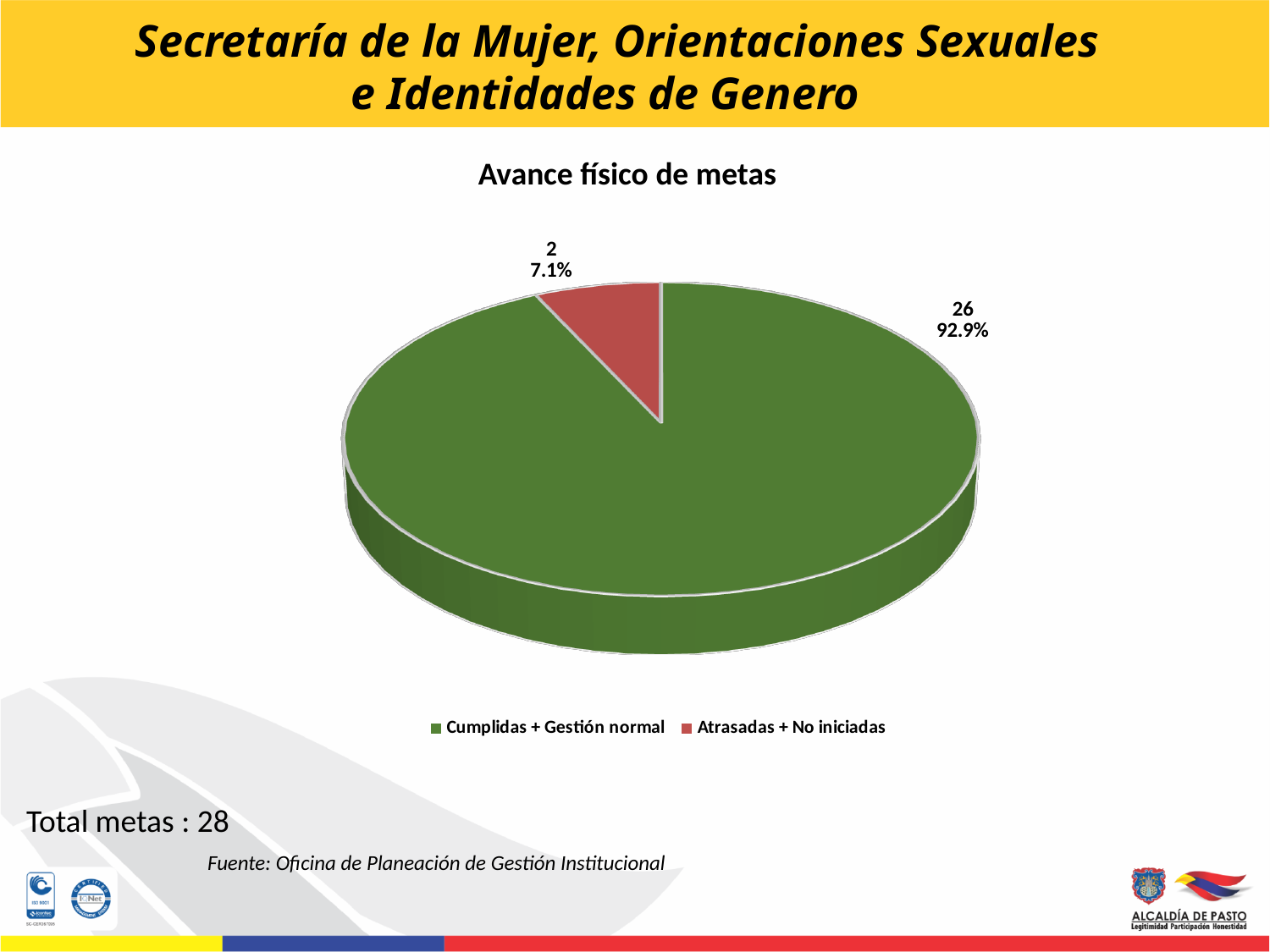
What is the value for Cumplidas + Gestión normal? 26 What share of the pie does Cumplidas + Gestión normal represent? 92.9% What is the title of the chart? Avance físico de metas What share of the pie does Atrasadas + No iniciadas represent? 7.1% Which category has the largest slice? Cumplidas + Gestión normal What is the difference between the values for Cumplidas + Gestión normal and Atrasadas + No iniciadas? 24 What is the value for Atrasadas + No iniciadas? 2 What colour is the slice for Atrasadas + No iniciadas? Red Which category has the smallest slice? Atrasadas + No iniciadas What type of chart is shown on the slide? Pie chart How many slices does the pie chart have? 2 How many series does the legend list? 2